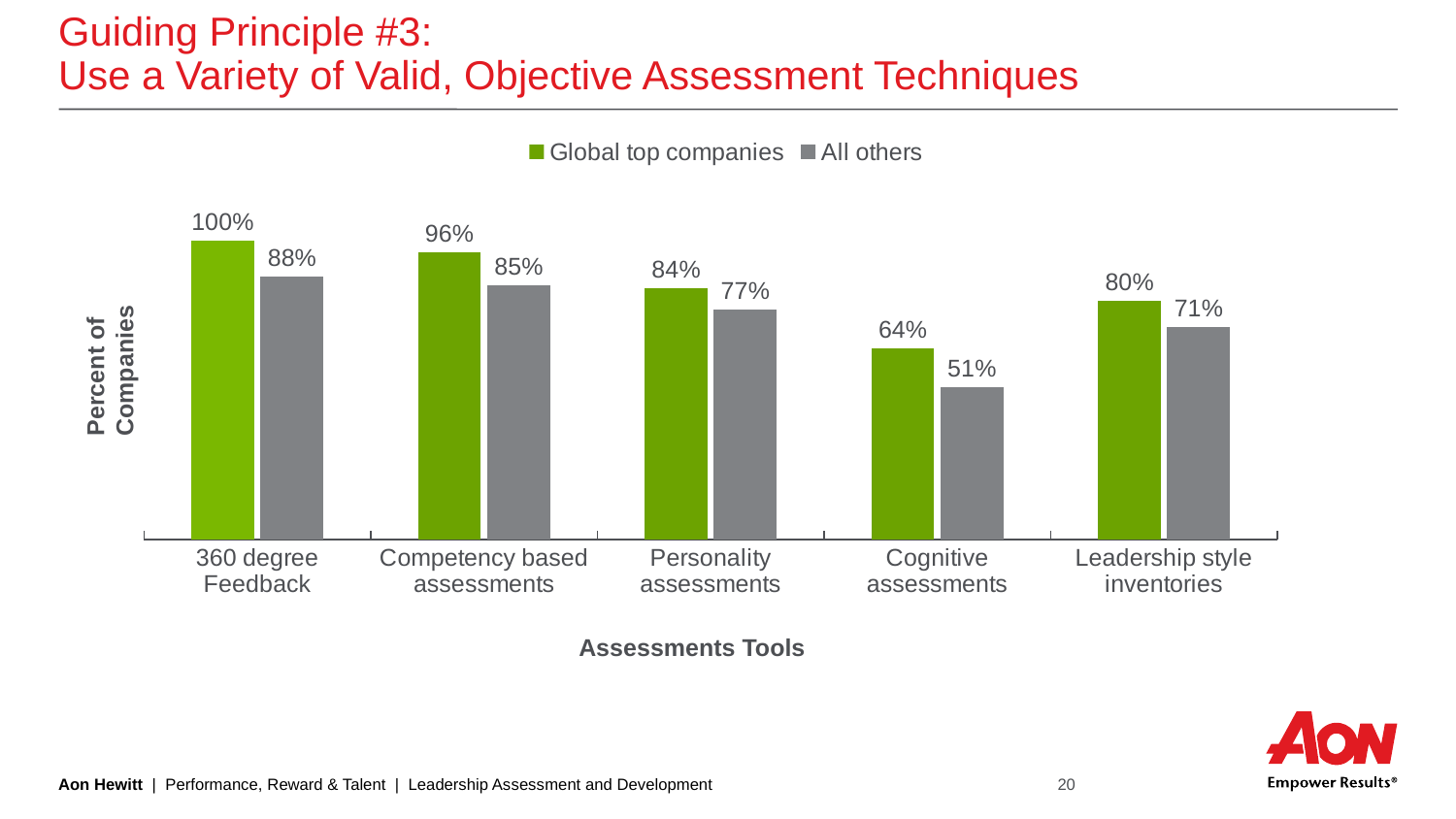
Which assessment tool has the highest value for All others? 360 degree Feedback What kind of chart is shown on the slide? Bar chart What percentage of All others use Cognitive assessments? 51% What is the value for All others for Leadership style inventories? 71% How many series does the legend list? 2 What is the difference between Global top companies and All others for Competency based assessments? 11 percentage points What is the difference between Global top companies and All others for Cognitive assessments? 13 percentage points What percentage of Global top companies use 360 degree Feedback? 100% Which is larger: the All others value for Personality assessments or the All others value for Leadership style inventories? Personality assessments What is the label of the x axis? Assessments Tools How many assessment tools are shown on the x axis? 5 Which assessment tool has the lowest value for Global top companies? Cognitive assessments